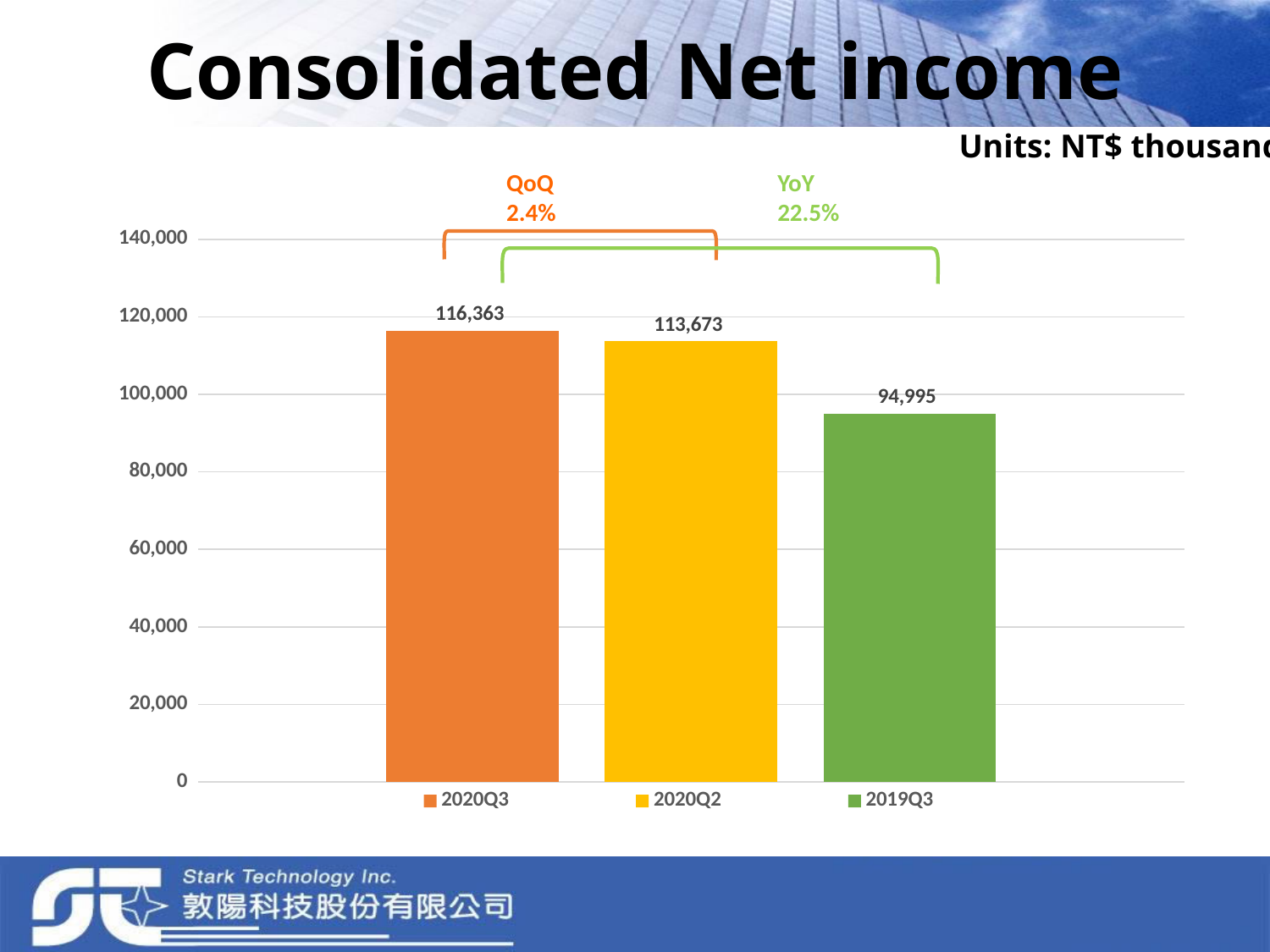
What is the consolidated net income for 2020Q3? 116,363 Which is larger, the net income for 2020Q2 or 2019Q3? 2020Q2 What YoY percentage change is shown on the chart? 22.5% What is the consolidated net income for 2019Q3? 94,995 How many bars are shown in the chart? 3 What is the consolidated net income for 2020Q2? 113,673 What is the difference between the 2020Q3 and 2020Q2 net income values? 2,690 Is the value for 2019Q3 greater or less than 100,000? less What is the difference between the 2020Q3 and 2019Q3 net income values? 21,368 What kind of chart is shown on the slide? bar chart Which period has the highest consolidated net income? 2020Q3 Which period has the lowest consolidated net income? 2019Q3